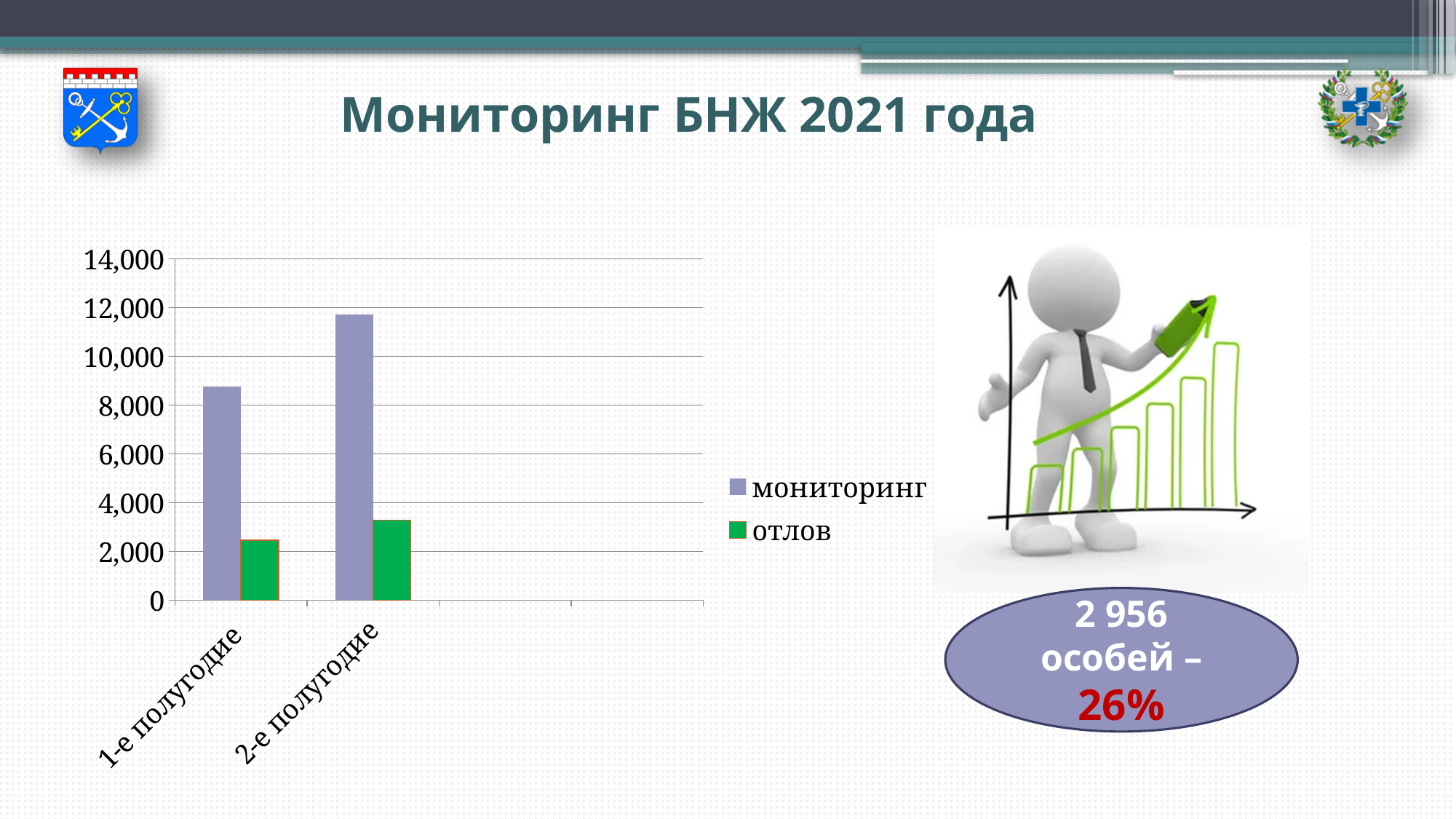
Which category has the lowest value for 'отлов'? 1-е полугодие Is the value for 'мониторинг' in 1-е полугодие greater or less than 10,000? less What kind of chart is shown on the slide? bar chart Is the value for 'мониторинг' in 2-е полугодие greater or less than 10,000? greater How many series does the chart legend list? 2 Which category has the highest value for 'мониторинг'? 2-е полугодие How many categories are shown on the x axis of the chart? 2 Do the values for 'мониторинг' rise or fall from 1-е полугодие to 2-е полугодие? rise Which series does the legend list first? мониторинг Is the value for 'отлов' in 2-е полугодие greater or less than 4,000? less Which is larger in 1-е полугодие: 'мониторинг' or 'отлов'? мониторинг What colour are the bars for the series 'отлов'? green